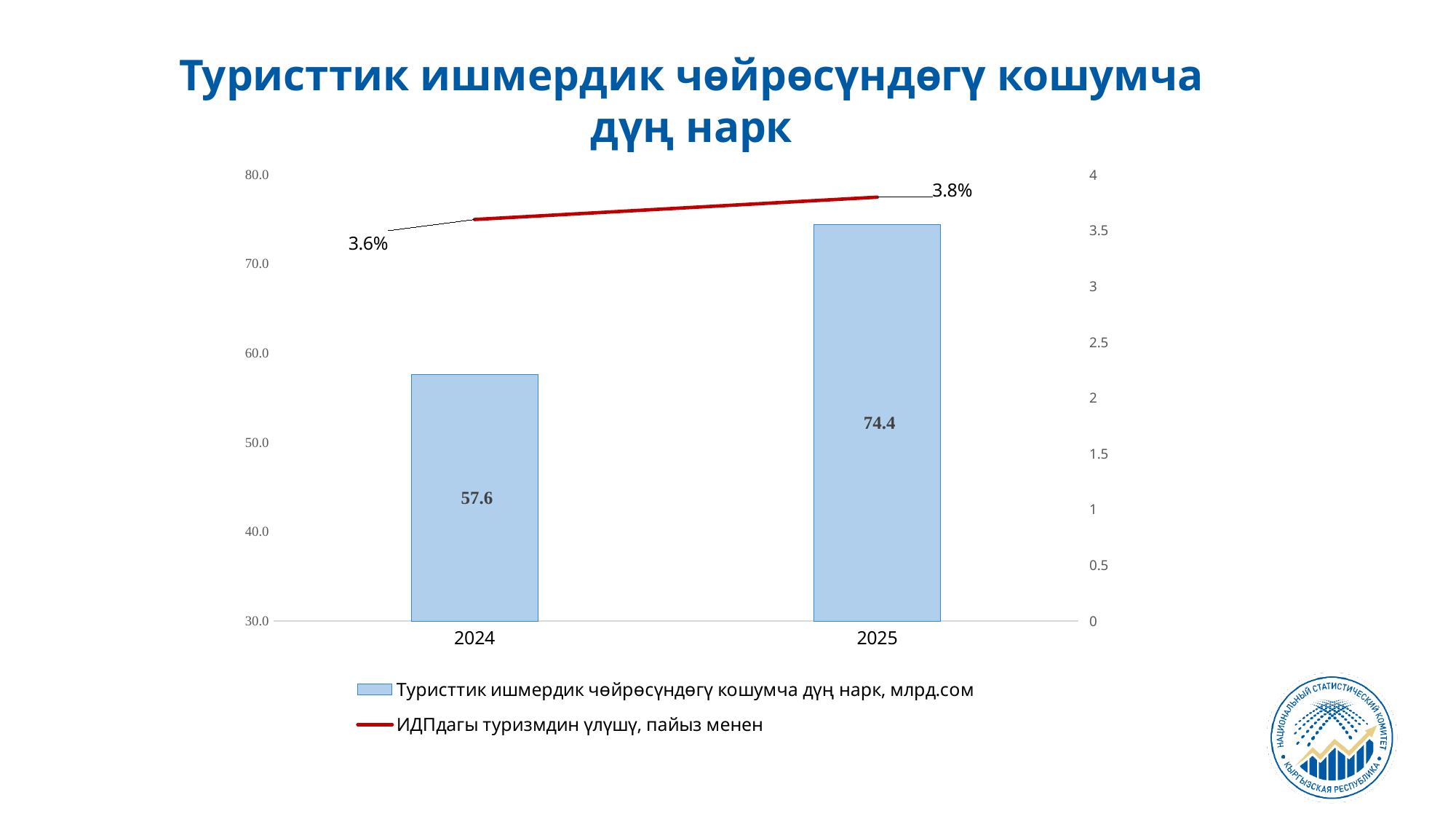
What is the value of the red line (ИДПдагы туризмдин үлүшү) for 2024? 3.6% What colour is the line series in the chart? Red Which year has the higher bar value? 2025 What is the value of the bar for 2024? 57.6 What is the value of the bar for 2025? 74.4 What is the value of the red line (ИДПдагы туризмдин үлүшү) for 2025? 3.8% How many years are shown on the x axis? 2 Is the bar value for 2024 greater or less than 60.0? less How many series does the legend list? 2 What is the difference between the bar values for 2025 and 2024? 16.8 Do the bar values rise or fall from 2024 to 2025? rise Which year has the lower bar value? 2024